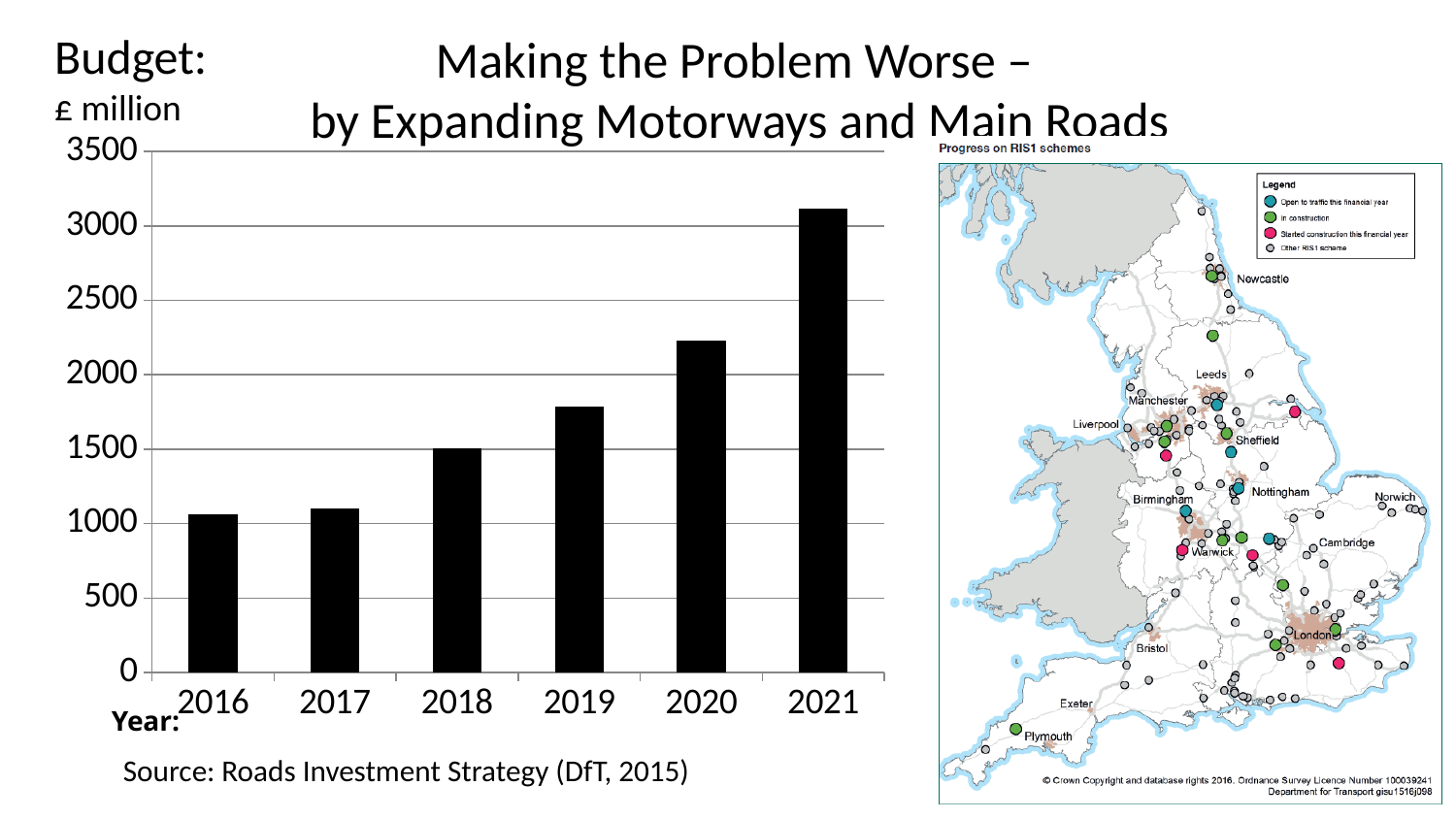
What unit is the budget axis of the bar chart measured in? £ million Is the budget for 2019 greater or less than 2000? less Which year has the highest budget in the bar chart? 2021 Do the budget values rise or fall from 2016 to 2021? rise Is the budget for 2016 greater or less than 1000? greater Is the budget for 2017 greater or less than 1500? less Which is larger, the budget for 2020 or the budget for 2019? 2020 What kind of chart is shown on the slide? bar chart How many years are plotted on the bar chart? 6 Which year has the lowest budget in the bar chart? 2016